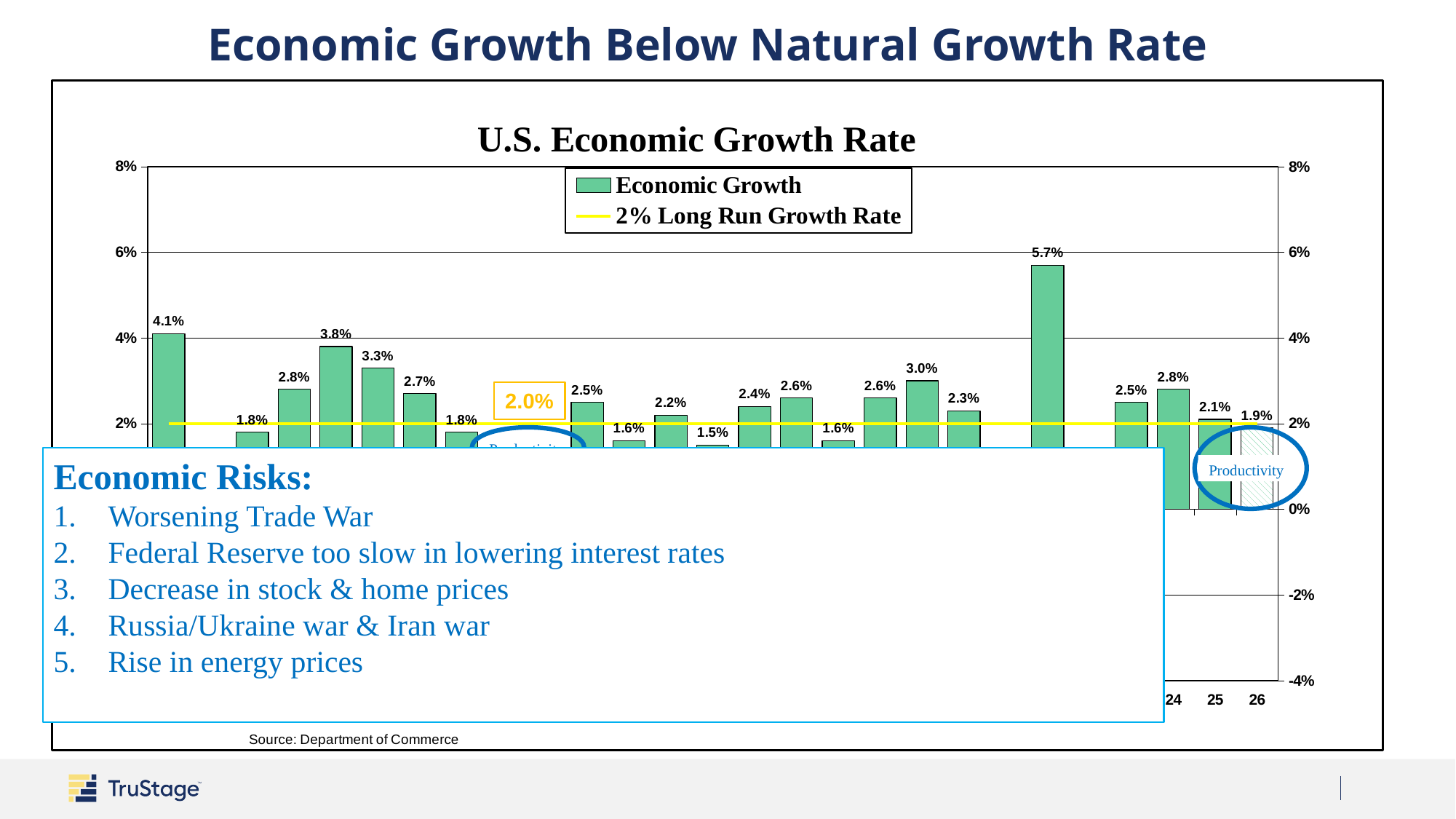
What is the economic growth rate shown for 25? 2.1% Do the economic growth rate values rise or fall from 24 to 26? Fall What is the difference between the economic growth rate for 24 and for 25? 0.7% Which has a higher economic growth rate, 25 or 26? 25 What value does the yellow horizontal line represent according to the legend? 2% Long Run Growth Rate Is the economic growth rate for 26 greater or less than 2%? less What is the highest economic growth rate value labeled on the chart? 5.7% What is the title of the chart? U.S. Economic Growth Rate What is the economic growth rate shown for 26? 1.9% What type of chart is used to show the U.S. Economic Growth Rate? Bar chart How many series does the chart legend list? 2 What is the economic growth rate shown for 24? 2.8%